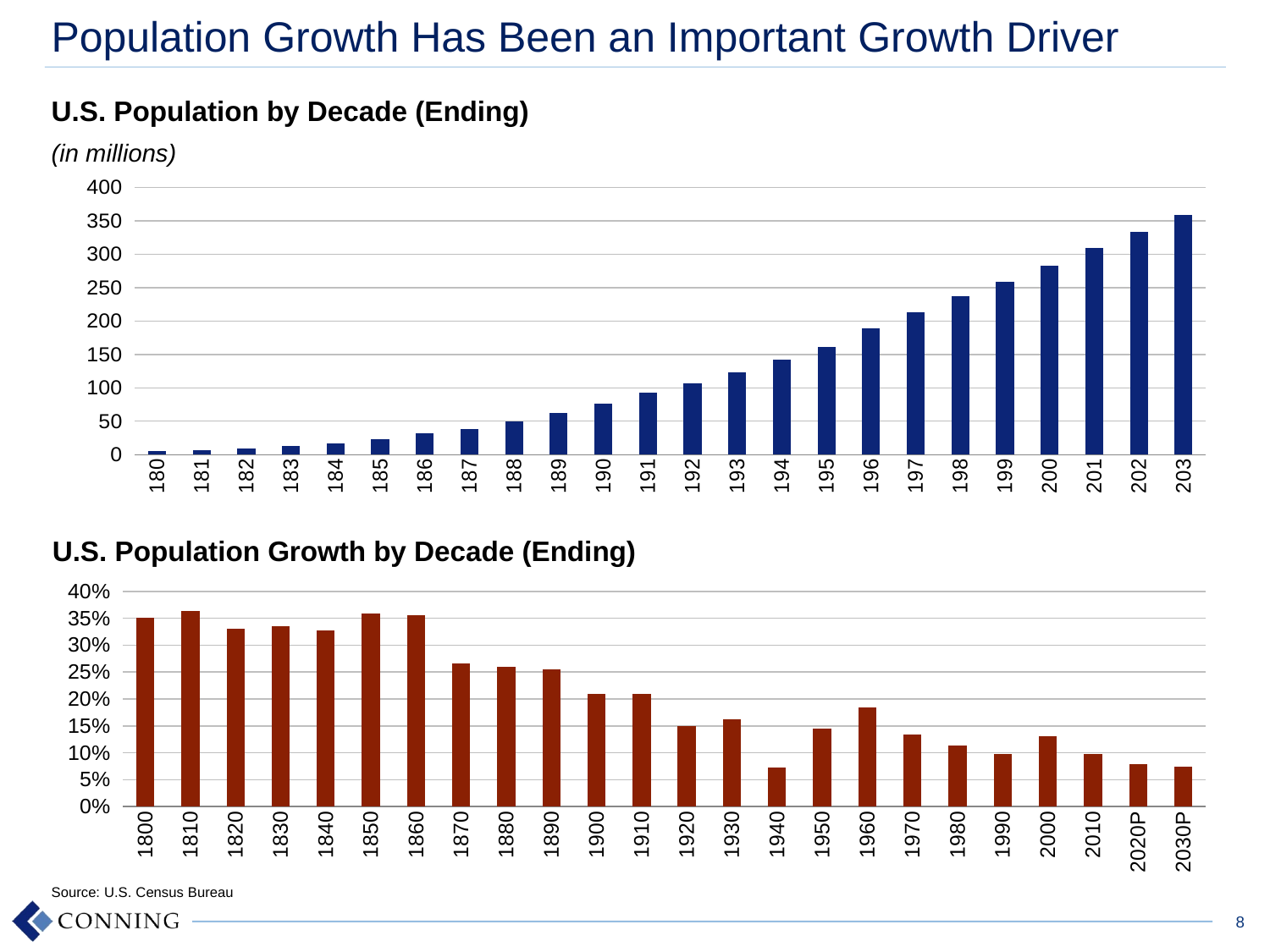
What unit is stated for the 'U.S. Population by Decade (Ending)' chart? in millions In the 'U.S. Population Growth by Decade (Ending)' chart, is the value for 1940 greater or less than 10%? less What kind of chart is the 'U.S. Population by Decade (Ending)' chart? Bar chart In the 'U.S. Population Growth by Decade (Ending)' chart, which is larger, the value for 1870 or the value for 1920? 1870 How many bars are plotted in the 'U.S. Population Growth by Decade (Ending)' chart? 24 In the 'U.S. Population by Decade (Ending)' chart, is the value for the bar labeled 190 greater or less than 100? less In the 'U.S. Population Growth by Decade (Ending)' chart, is the value for 1800 greater or less than 30%? greater In the 'U.S. Population by Decade (Ending)' chart, which bar is the highest? The rightmost bar, labeled 203 In the 'U.S. Population by Decade (Ending)' chart, do the values rise or fall from left to right? Rise In the 'U.S. Population Growth by Decade (Ending)' chart, do the values generally rise or fall from left to right? Fall How many bars are plotted in the 'U.S. Population by Decade (Ending)' chart? 24